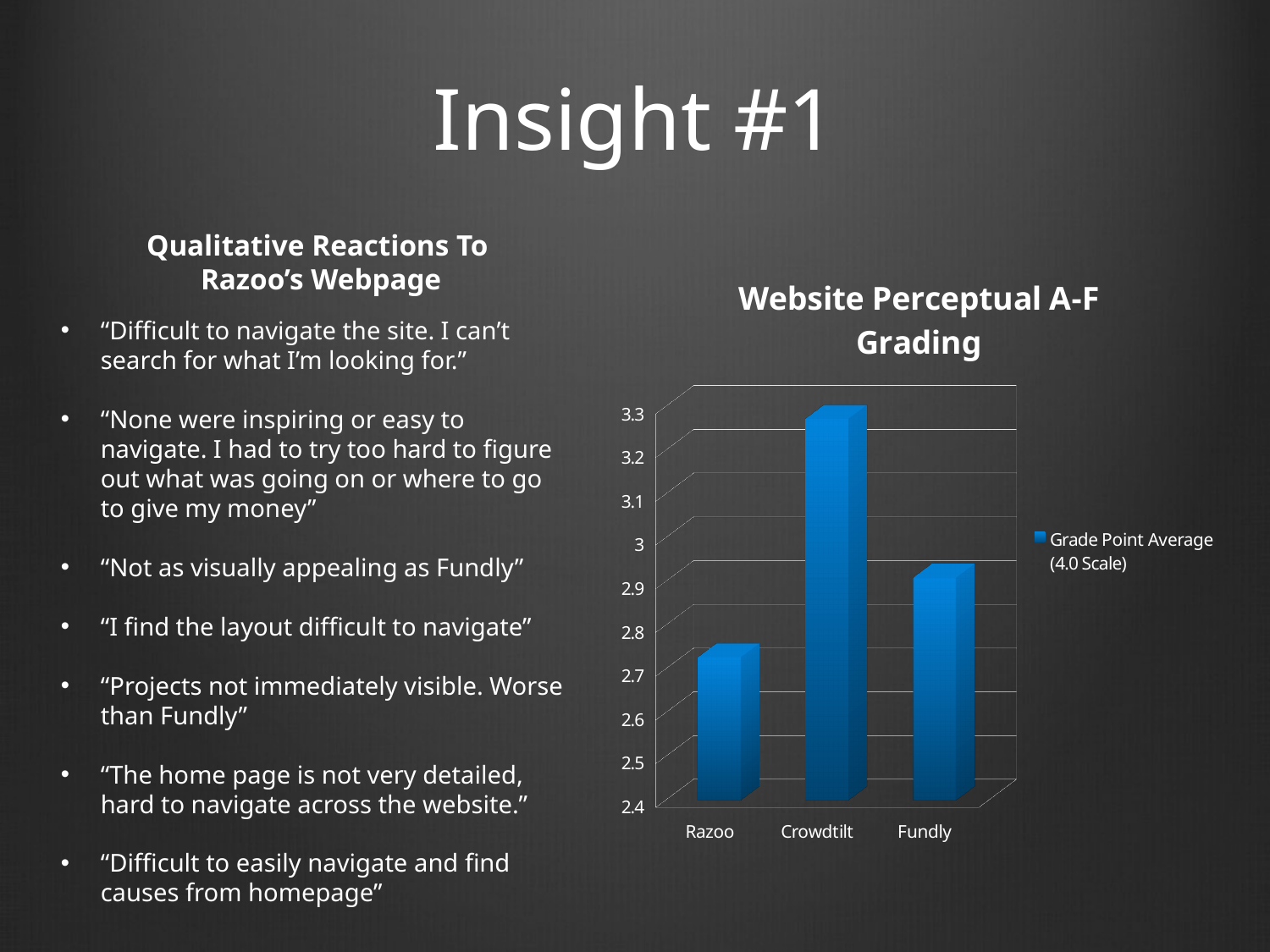
What kind of chart is shown on the slide? Bar chart What series name does the legend show? Grade Point Average (4.0 Scale) How many series does the chart's legend list? 1 What is the title of the chart? Website Perceptual A-F Grading Is the value for Crowdtilt greater or less than 3.2? greater Is the value for Fundly greater or less than 3? less Which website has the highest grade point average? Crowdtilt Is the value for Fundly greater or less than 2.8? greater Which has a higher grade point average, Fundly or Razoo? Fundly Which website has the lowest grade point average? Razoo How many websites are plotted on the chart? 3